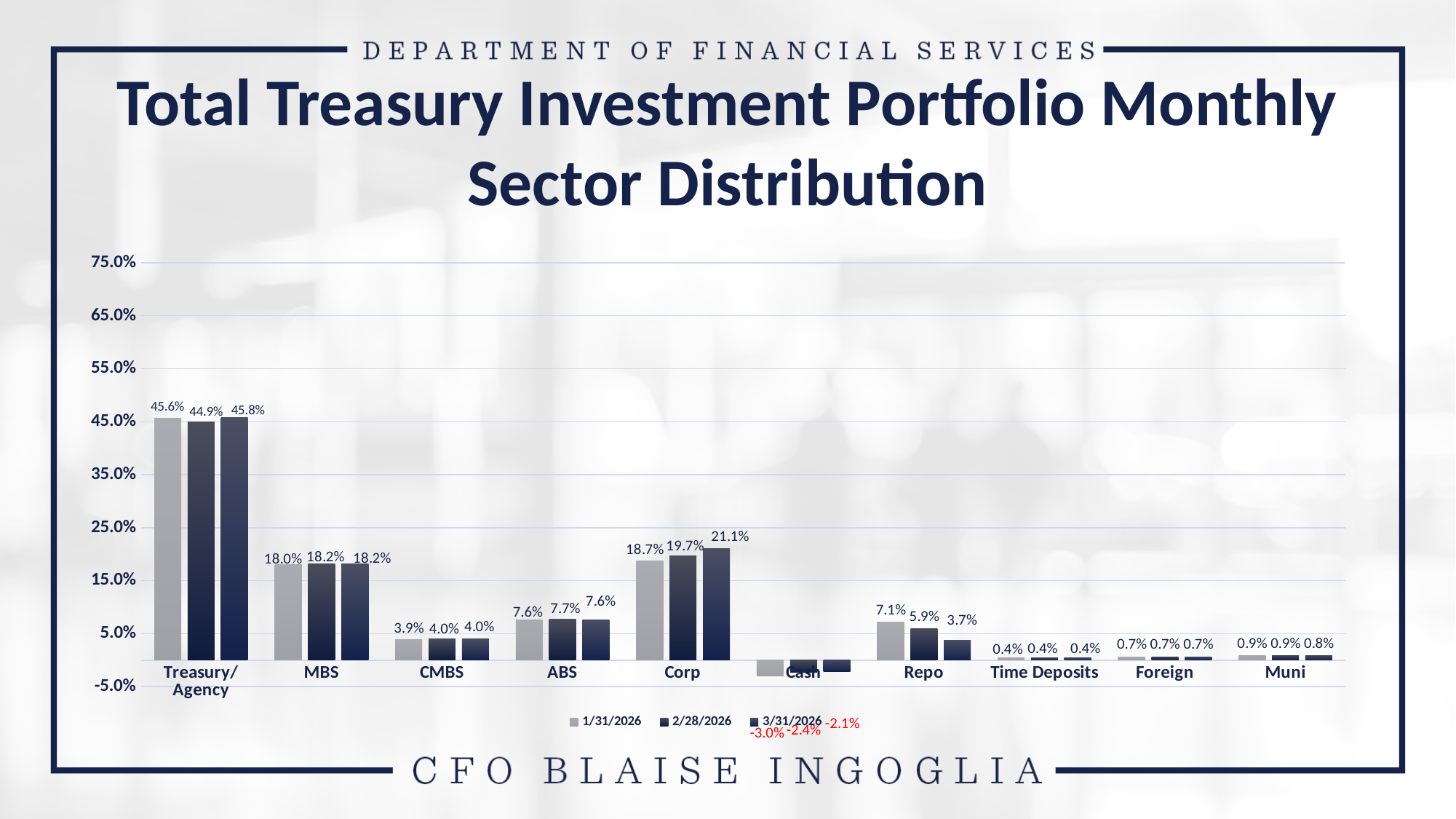
What is the value for Corp on 2/28/2026? 19.7% What is the value for Repo on 1/31/2026? 7.1% Do the Corp values rise or fall from 1/31/2026 to 3/31/2026? rise Which is larger, the MBS value on 1/31/2026 or the Corp value on 1/31/2026? Corp What is the difference between the Corp values on 3/31/2026 and 1/31/2026? 2.4% How many sector categories are shown on the x axis? 10 What is the title of the chart? Total Treasury Investment Portfolio Monthly Sector Distribution Which sector has the highest value on 1/31/2026? Treasury/Agency How many series does the legend list? 3 What kind of chart is shown on the slide? bar chart What is the difference between the Repo values on 1/31/2026 and 3/31/2026? 3.4% What is the value for Treasury/Agency on 3/31/2026? 45.8%